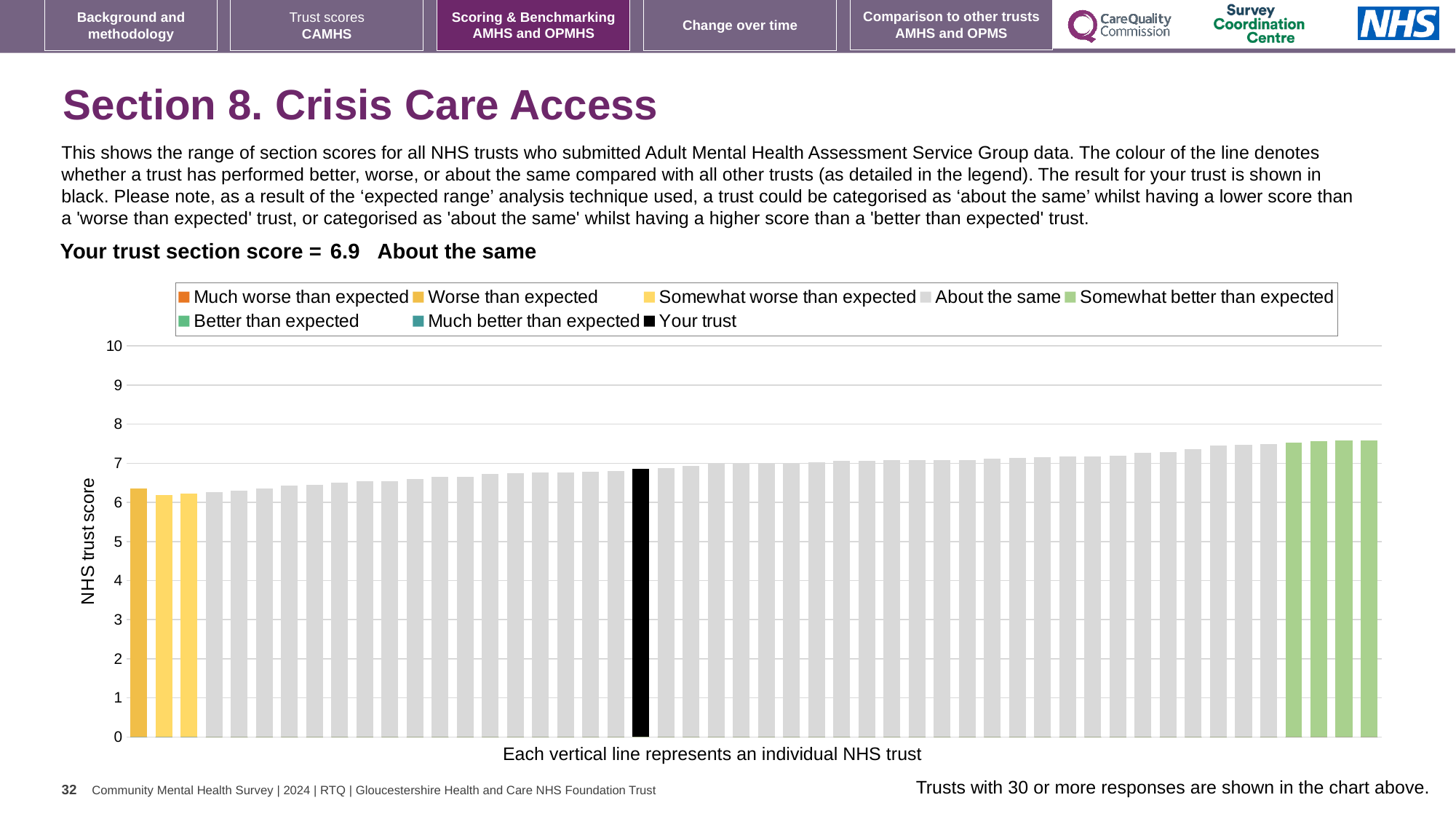
Do the bar values rise or fall from left to right across the chart? rise Is the value for your trust (the black bar) greater or less than 7? less Is the value for your trust (the black bar) greater or less than 5? greater What is the section score for your trust shown on the slide? 6.9 Is the shortest bar in the chart greater or less than 7? less Is the black bar for your trust higher or lower than the orange bar at the far left? higher What kind of chart is shown on the slide? bar chart How many entries does the chart legend list? 8 What is the label on the vertical axis of the chart? NHS trust score What colour is used for the 'Your trust' bar in the chart? black Which category is your trust's section score placed in? About the same